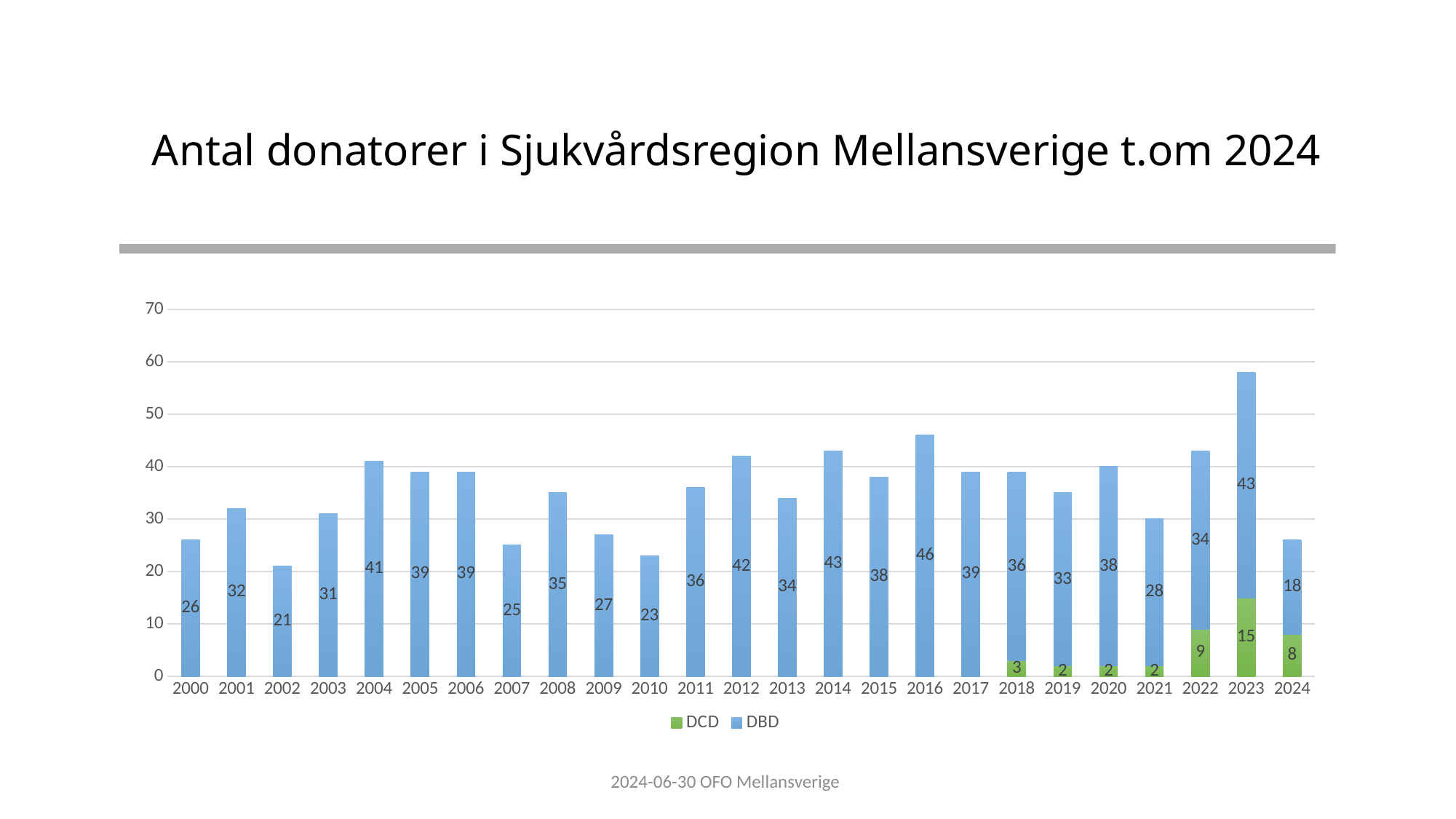
What is the total of the stacked bar for 2023? 58 What kind of chart is shown on the slide? Stacked bar chart Which year has the larger DBD value, 2004 or 2005? 2004 Which year has the lowest DBD value? 2024 How many series does the legend list? 2 What is the total of the stacked bar for 2024? 26 Which year has the highest DBD value? 2016 What is the difference between the DBD values for 2022 and 2023? 9 What is the DBD value for 2016? 46 What is the DCD value for 2023? 15 What is the DBD value for 2024? 18 How many years are shown on the x axis? 25